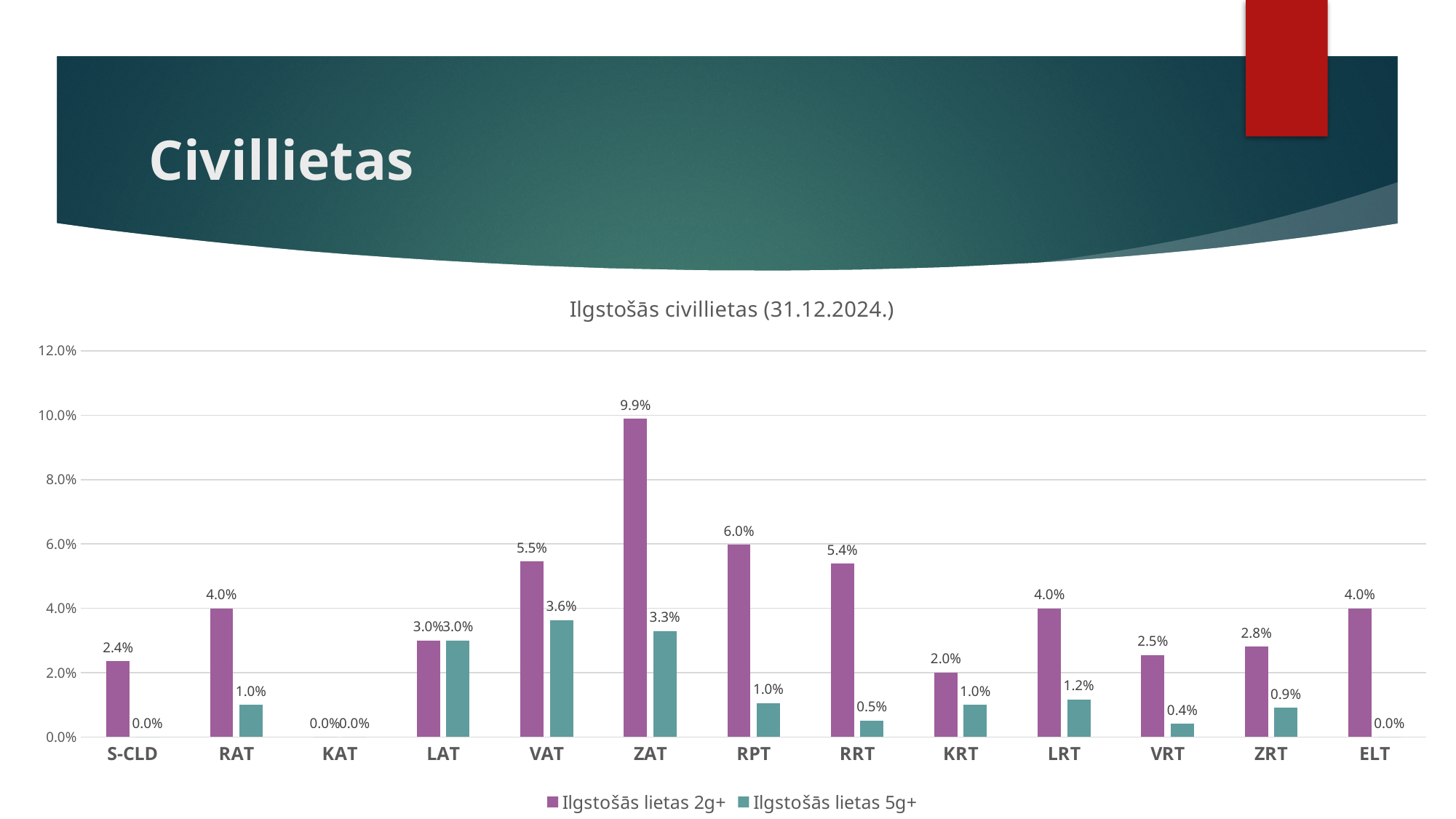
How many series does the legend list? 2 What is the difference between the 'Ilgstošās lietas 2g+' and 'Ilgstošās lietas 5g+' values for RPT? 5.0% What is the value of 'Ilgstošās lietas 2g+' for ZAT? 9.9% Which is larger: the 'Ilgstošās lietas 2g+' value for VAT or for RPT? RPT Which category has the highest value for 'Ilgstošās lietas 5g+'? VAT What is the value of 'Ilgstošās lietas 5g+' for VAT? 3.6% How many categories are shown on the x axis? 13 What is the value of 'Ilgstošās lietas 2g+' for RRT? 5.4% What kind of chart is shown on the slide? Bar chart Which category has the highest value for 'Ilgstošās lietas 2g+'? ZAT What is the title of the chart? Ilgstošās civillietas (31.12.2024.) Is the 'Ilgstošās lietas 2g+' value for ZAT greater or less than 8.0%? greater